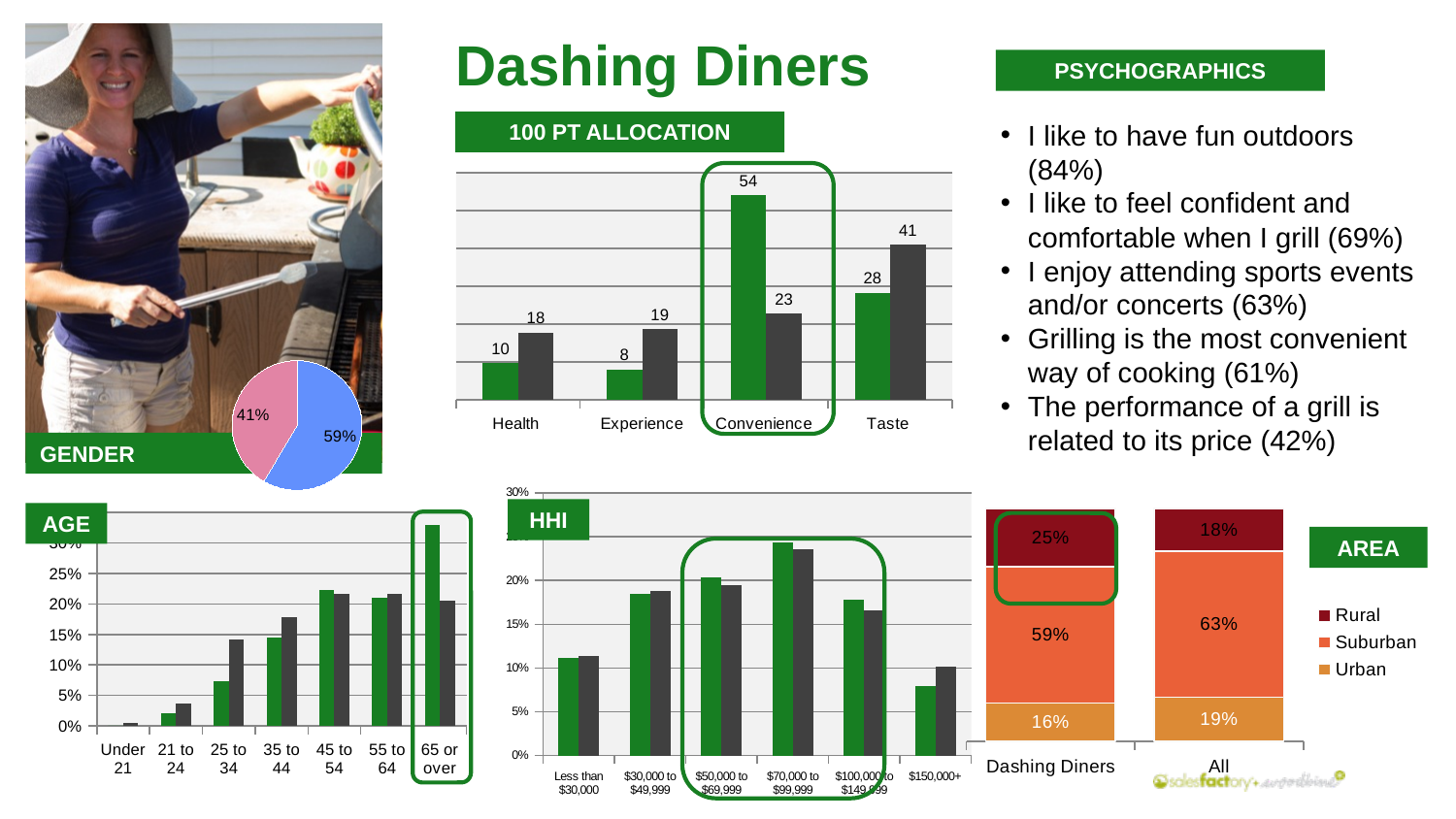
In the GENDER pie chart, what is the share of the blue slice? 59% In the AREA chart, what is the Rural share for All? 18% In the 100 PT ALLOCATION chart, what is the value of the dark gray bar for Taste? 41 In the 100 PT ALLOCATION chart, which category has the highest green bar? Convenience In the 100 PT ALLOCATION chart, what is the difference between the green and dark gray bars for Convenience? 31 In the HHI chart, is the green bar for Less than $30,000 greater or less than 15%? less In the AREA chart, how many series does the legend list? 3 In the 100 PT ALLOCATION chart, which category has the lowest green bar? Experience In the AGE chart, is the green bar for 65 or over greater or less than 25%? greater In the 100 PT ALLOCATION chart, how many categories are shown on the x axis? 4 In the 100 PT ALLOCATION chart, what is the value of the green bar for Convenience? 54 In the AREA chart, what is the Suburban share for Dashing Diners? 59%